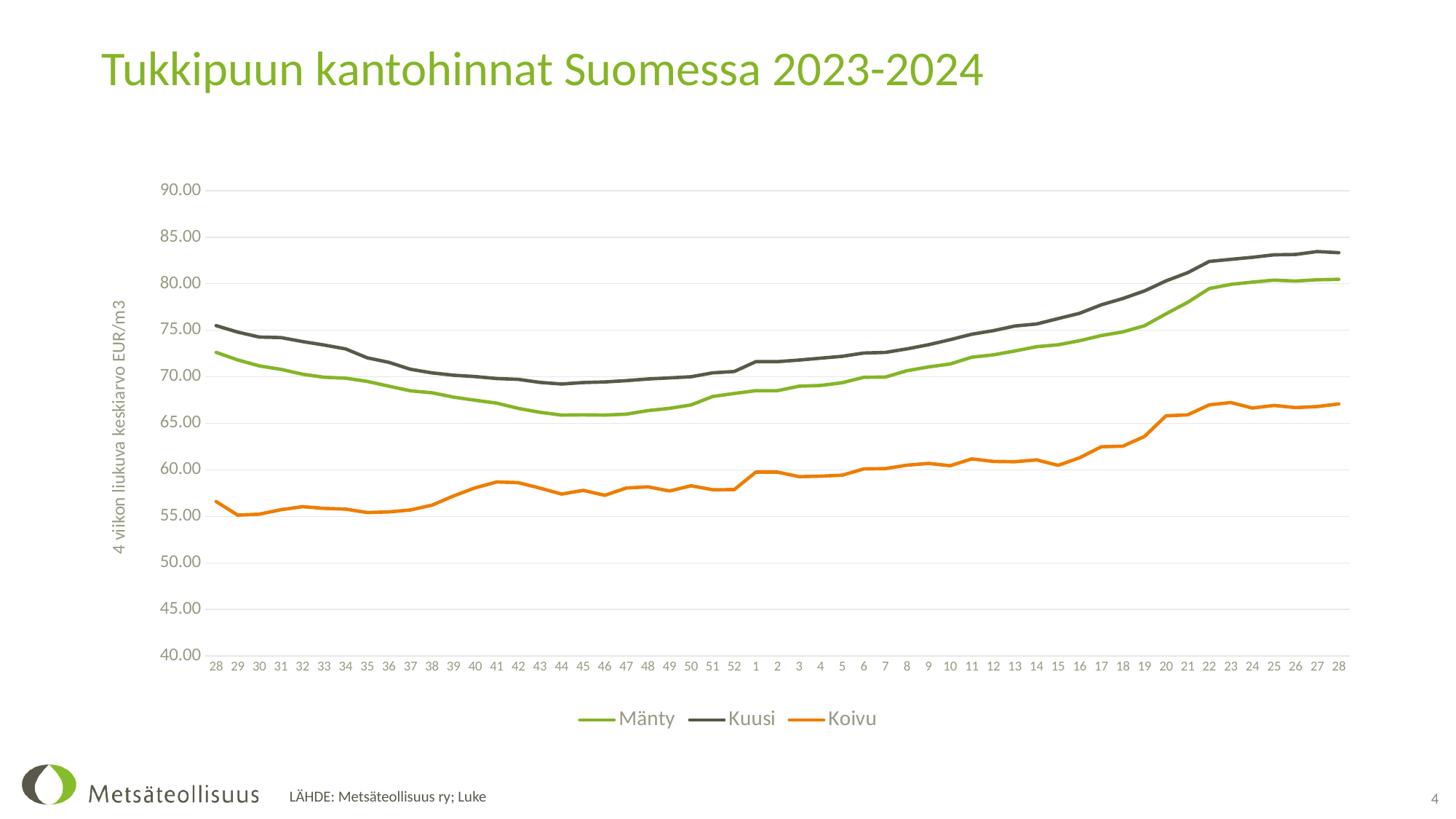
How many series does the legend list? 3 Is the value for Koivu at week 41 greater or less than 60.00? less Is the value for Kuusi at week 44 greater or less than 70.00? less Is the value for Kuusi at the final week 28 greater or less than 80.00? greater What is the title of the chart? Tukkipuun kantohinnat Suomessa 2023-2024 At the first week 28, which is larger, the value for Kuusi or the value for Mänty? Kuusi What kind of chart is shown on the slide? line chart Which series are listed in the legend? Mänty, Kuusi, Koivu Does the Kuusi line rise or fall from the first week 28 to week 44? fall How many weekly points are plotted along the x axis? 53 Which series has the highest value at the last week (28) on the x axis? Kuusi Which series has the lowest values across the whole chart? Koivu